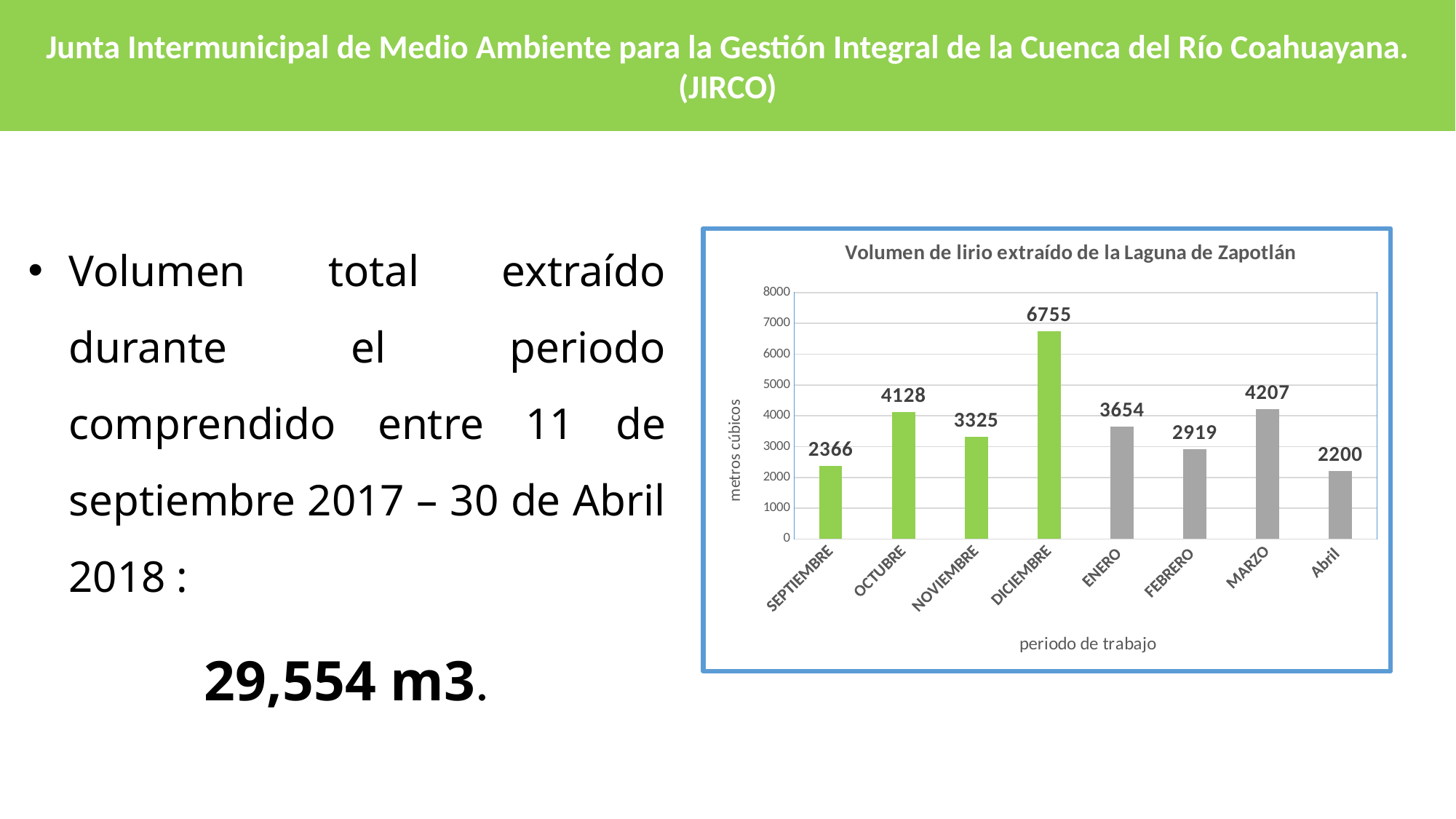
What is the label of the y axis? metros cúbicos What is the title of the chart? Volumen de lirio extraído de la Laguna de Zapotlán What kind of chart is this? bar chart Is the value for FEBRERO greater or less than 3000? less Which is larger, the value for OCTUBRE or the value for MARZO? MARZO What is the value for DICIEMBRE? 6755 Which month has the highest volume? DICIEMBRE What is the difference between the values for DICIEMBRE and ENERO? 3101 What is the value for MARZO? 4207 What is the value for SEPTIEMBRE? 2366 Which month has the lowest volume? Abril How many months are shown on the x axis? 8